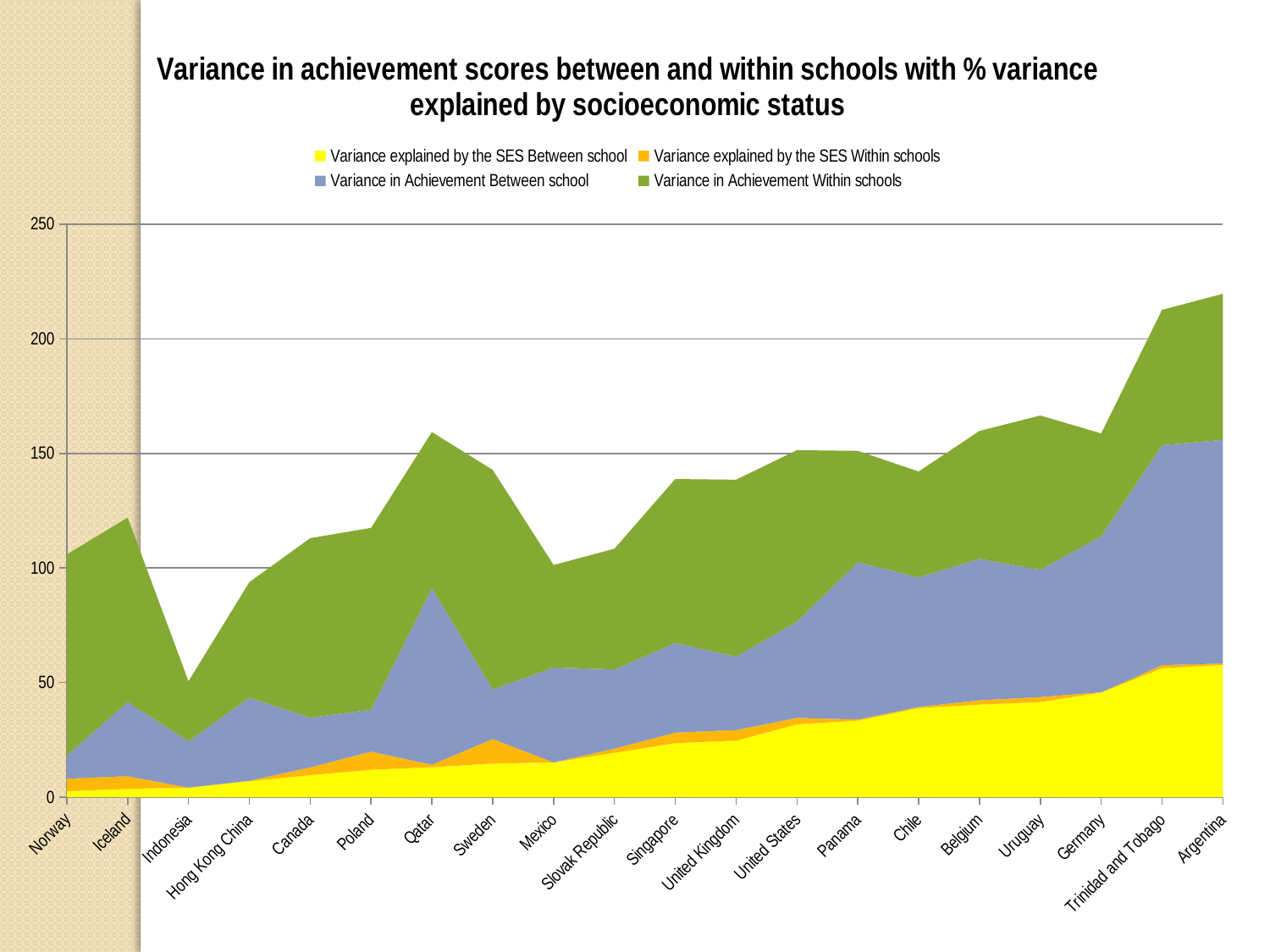
Is the total stacked value for Qatar greater or less than 100? greater Which country has the lowest total stacked value in the chart? Indonesia Is the total stacked value for Indonesia greater or less than 100? less Which series is shown in green in the chart's legend? Variance in Achievement Within schools Which country has the highest total stacked value in the chart? Argentina Do the total stacked values generally rise or fall from Norway on the left to Argentina on the right? rise How many series does the chart's legend list? 4 Which has the larger total stacked value, Argentina or Norway? Argentina How many countries are shown along the x axis of the chart? 20 What kind of chart is shown on the slide? Stacked area chart Is the total stacked value for Argentina greater or less than 200? greater